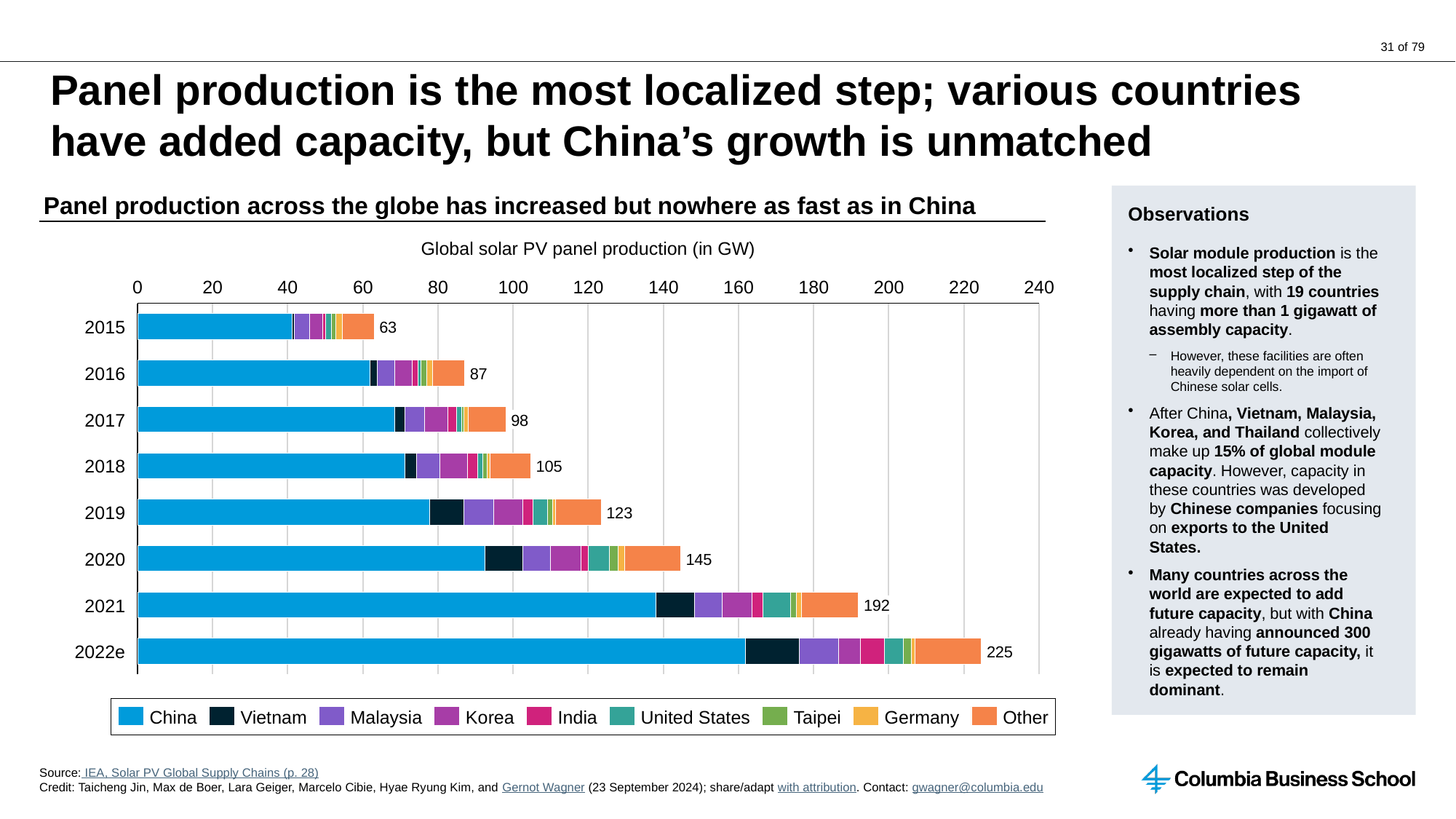
Which year has the highest total panel production? 2022e Do the total values rise or fall from 2015 to 2022e? Rise What is the total global solar PV panel production shown for 2022e? 225 Which total is larger, 2017 or 2018? 2018 Which year has the lowest total panel production? 2015 Is the China segment of the 2022e bar greater or less than 140? greater How many years are shown on the chart? 8 How many series does the legend list? 9 What is the total value labelled for the 2019 bar? 123 What kind of chart is shown on the slide? Stacked bar chart What is the total global solar PV panel production shown for 2015? 63 What is the difference between the total for 2021 and the total for 2020? 47